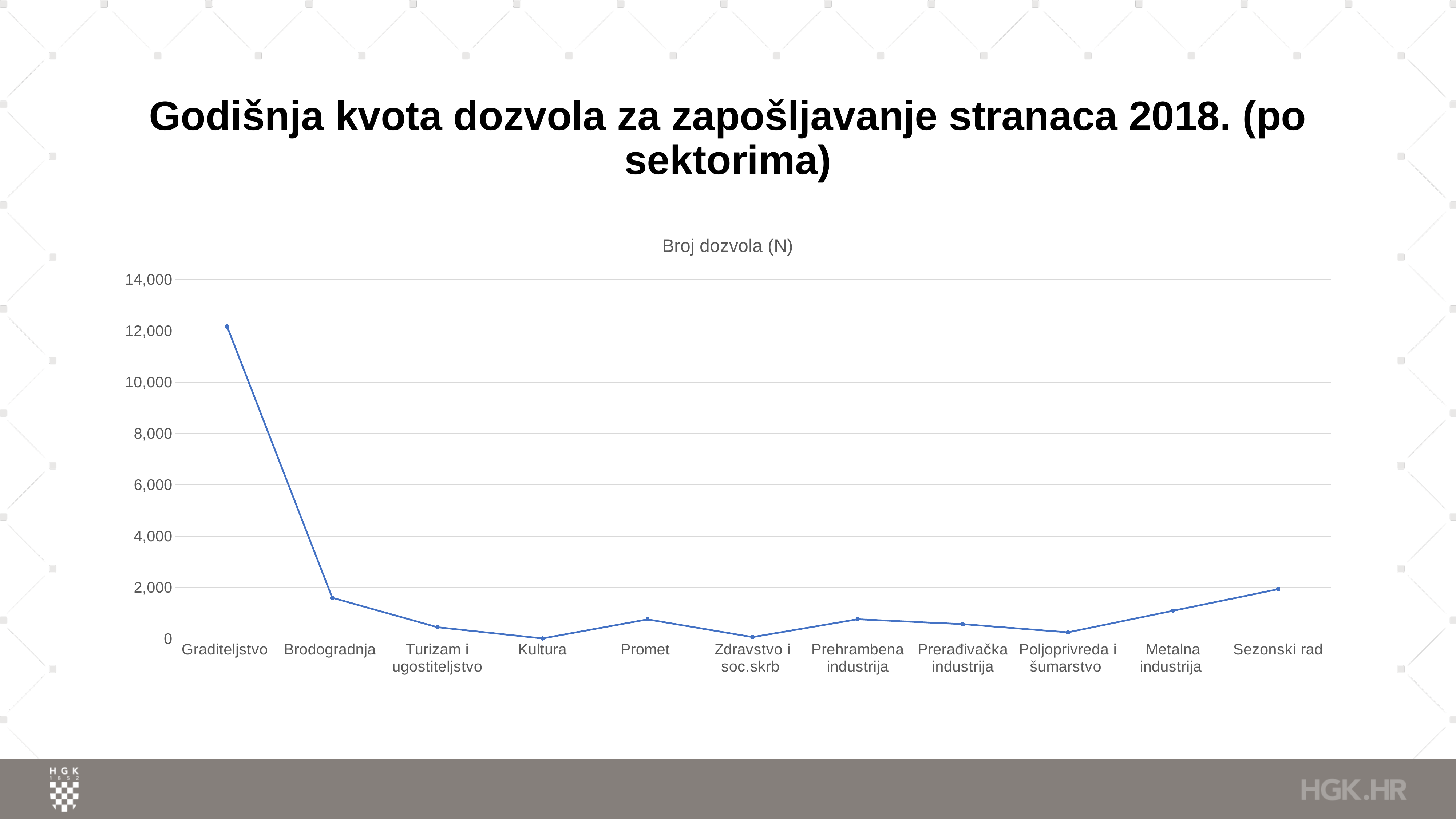
Is the value for Sezonski rad greater or less than 1,000? greater What is the title printed above the chart area? Broj dozvola (N) Which is larger, the value for Graditeljstvo or the value for Brodogradnja? Graditeljstvo Does the line rise or fall from Graditeljstvo to Brodogradnja? fall How many sectors are plotted along the x axis? 11 Does the line rise or fall from Poljoprivreda i šumarstvo to Sezonski rad? rise What kind of chart is shown on the slide? line chart Is the value for Brodogradnja greater or less than 2,000? less Which is larger, the value for Sezonski rad or the value for Metalna industrija? Sezonski rad Is the value for Kultura greater or less than 2,000? less Which sector has the highest number of permits? Graditeljstvo